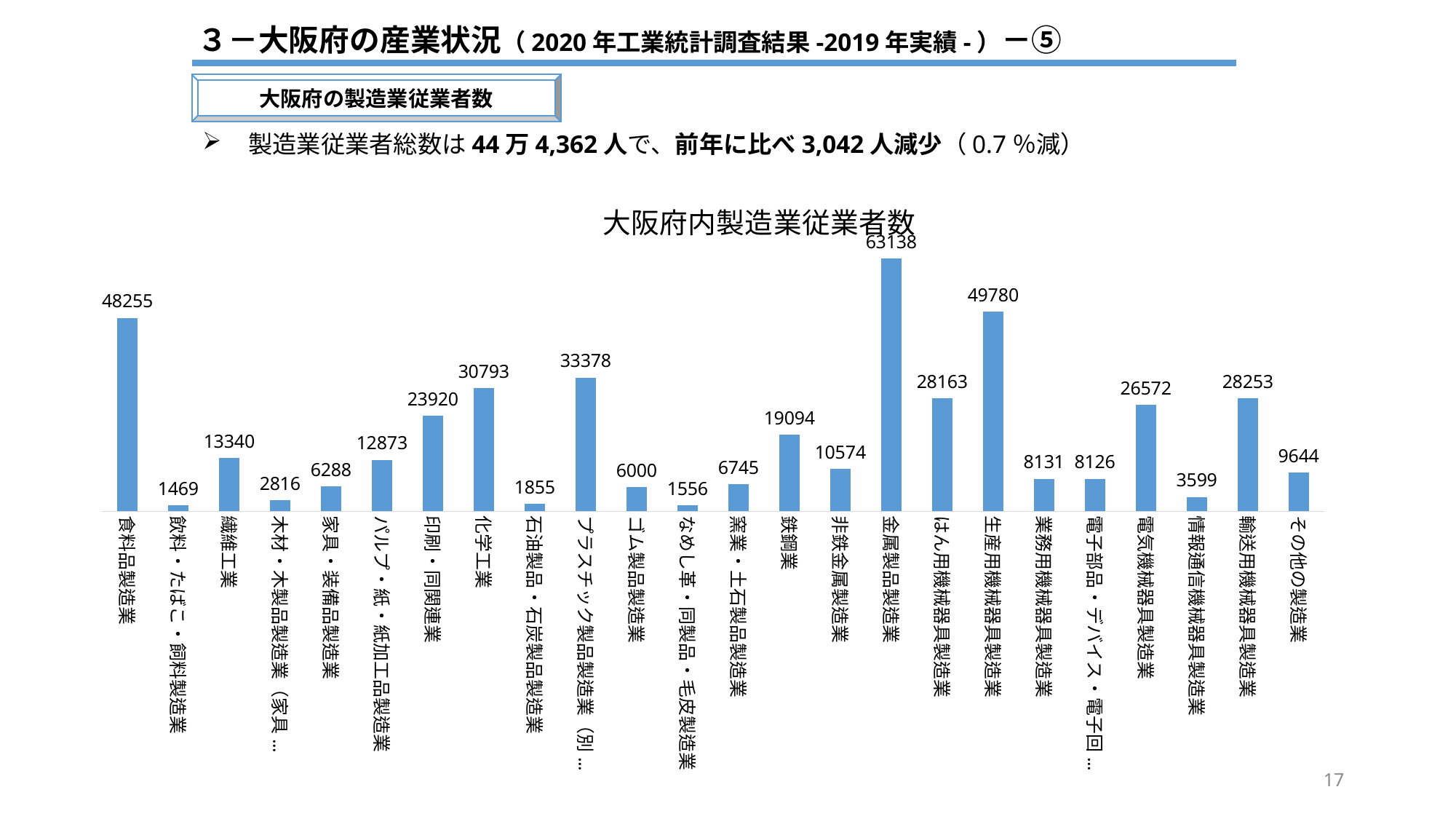
What is the difference between 金属製品製造業 and 生産用機械器具製造業? 13358 How many categories are shown in the chart? 24 What kind of chart is this? Bar chart What is the title of the chart? 大阪府内製造業従業者数 Which is larger, 化学工業 or プラスチック製品製造業? プラスチック製品製造業 What is the value for 食料品製造業? 48255 What is the value for 化学工業? 30793 What is the difference between 食料品製造業 and 化学工業? 17462 What is the value for 鉄鋼業? 19094 Which category has the highest value? 金属製品製造業 Which category has the lowest value? 飲料・たばこ・飼料製造業 What is the value for 輸送用機械器具製造業? 28253